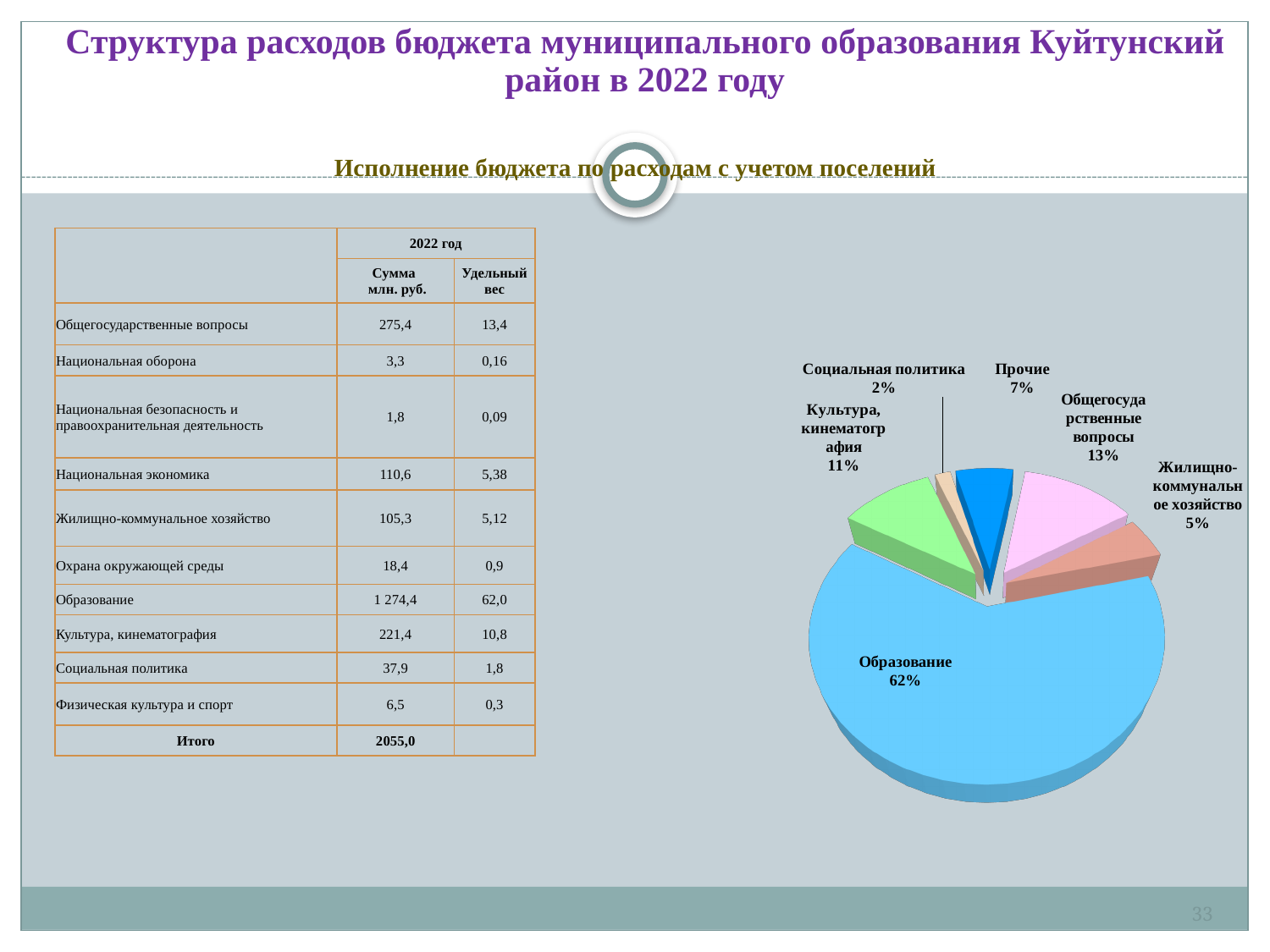
What share of the pie does Культура, кинематография have? 11% Which is larger, the share for Общегосударственные вопросы or the share for Культура, кинематография? Общегосударственные вопросы Which slice of the pie is the largest? Образование What share of the pie does Образование have? 62% What share of the pie does Жилищно-коммунальное хозяйство have? 5% What kind of chart is shown on the slide? pie chart Which slice of the pie is the smallest? Социальная политика What is the difference in percentage points between the share for Образование and the share for Общегосударственные вопросы? 49 How many slices does the pie chart have? 6